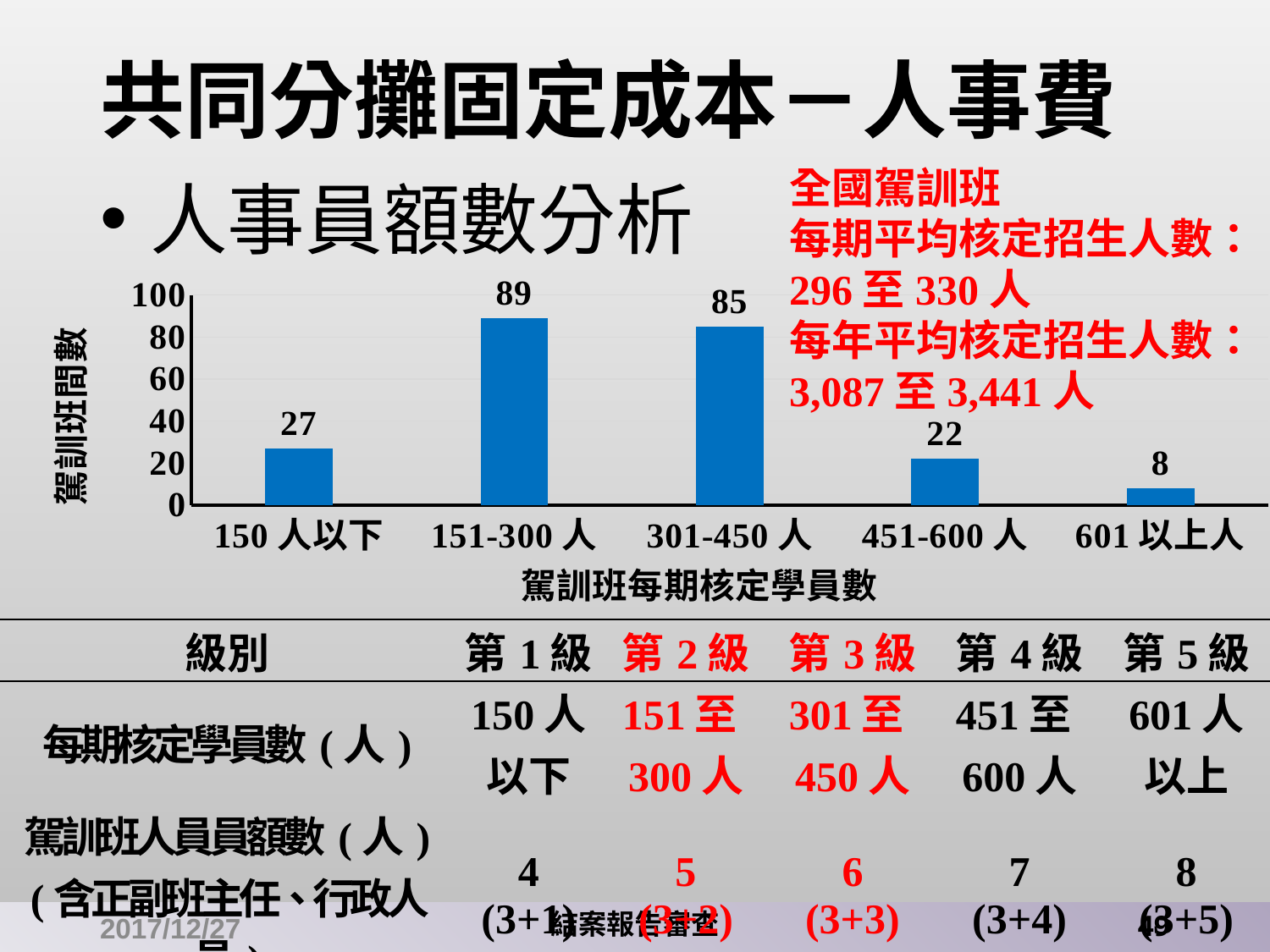
What is the value for the 601 以上人 category? 8 What is the label of the chart's y axis? 駕訓班間數 How many categories are shown on the x axis of the chart? 5 Is the value for 301-450 人 greater or less than 80? greater What is the difference between the 151-300 人 and 301-450 人 categories? 4 Which is larger, the value for 150 人以下 or the value for 451-600 人? 150 人以下 What is the value for the 150 人以下 category? 27 What kind of chart is shown on the slide? bar chart How many driving schools (駕訓班間數) are in the 151-300 人 category? 89 Which category has the highest number of driving schools? 151-300 人 Which category has the lowest number of driving schools? 601 以上人 What is the value for the 451-600 人 category? 22